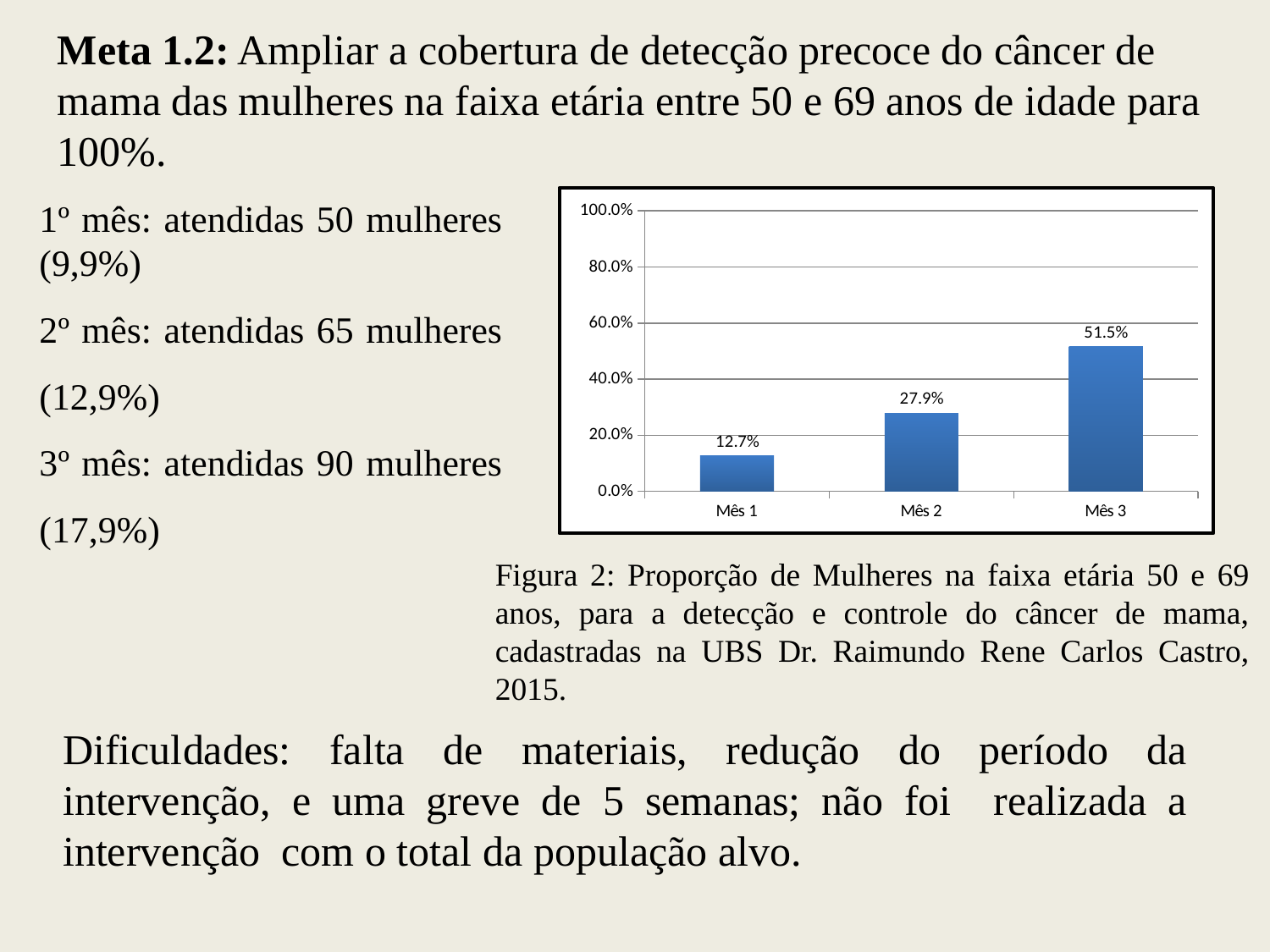
What is the value for Mês 2? 27.9% What is the difference between the values for Mês 2 and Mês 1? 15.2% What is the difference between the values for Mês 3 and Mês 2? 23.6% What is the value for Mês 1? 12.7% Which month has the highest value? Mês 3 Which month has the lowest value? Mês 1 Which is larger, the value for Mês 1 or the value for Mês 2? Mês 2 What kind of chart is shown? bar chart Is the value for Mês 3 greater or less than 40.0%? greater What is the value for Mês 3? 51.5% How many months are shown on the x axis? 3 Do the values rise or fall from Mês 1 to Mês 3? rise